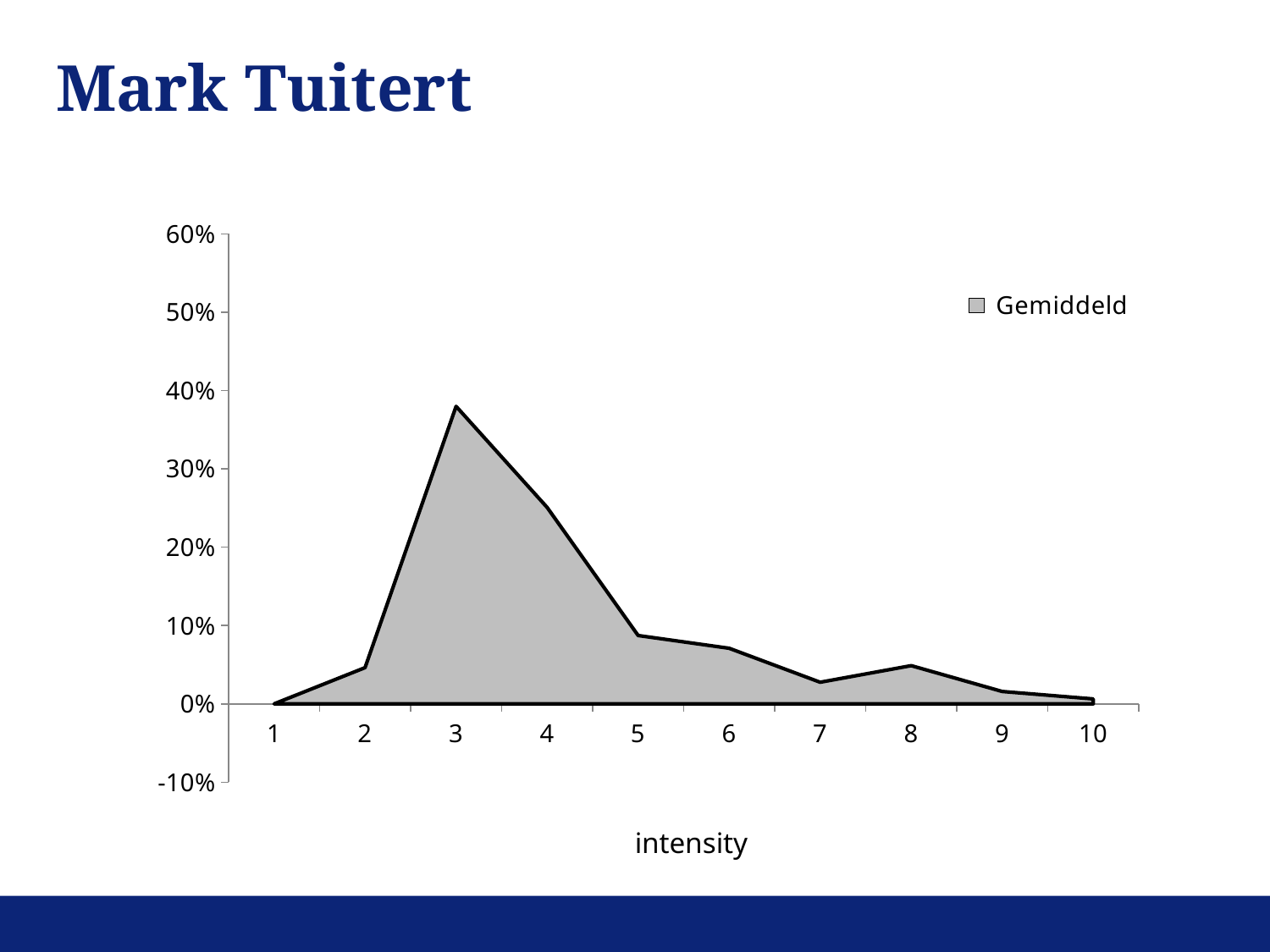
What is the name of the series shown in the legend? Gemiddeld How many series does the legend list? 1 Is the Gemiddeld value at intensity 3 greater or less than 30%? greater Which has the larger Gemiddeld value, intensity 3 or intensity 4? intensity 3 What type of chart is shown on the slide? area chart How many intensity points are plotted along the x axis? 10 What is the label of the x axis? intensity Is the Gemiddeld value at intensity 2 greater or less than 10%? less Do the Gemiddeld values rise or fall from intensity 3 to intensity 7? fall At which intensity value is the Gemiddeld value highest? 3 Is the Gemiddeld value at intensity 4 greater or less than 20%? greater What is the Gemiddeld value at intensity 1? 0%